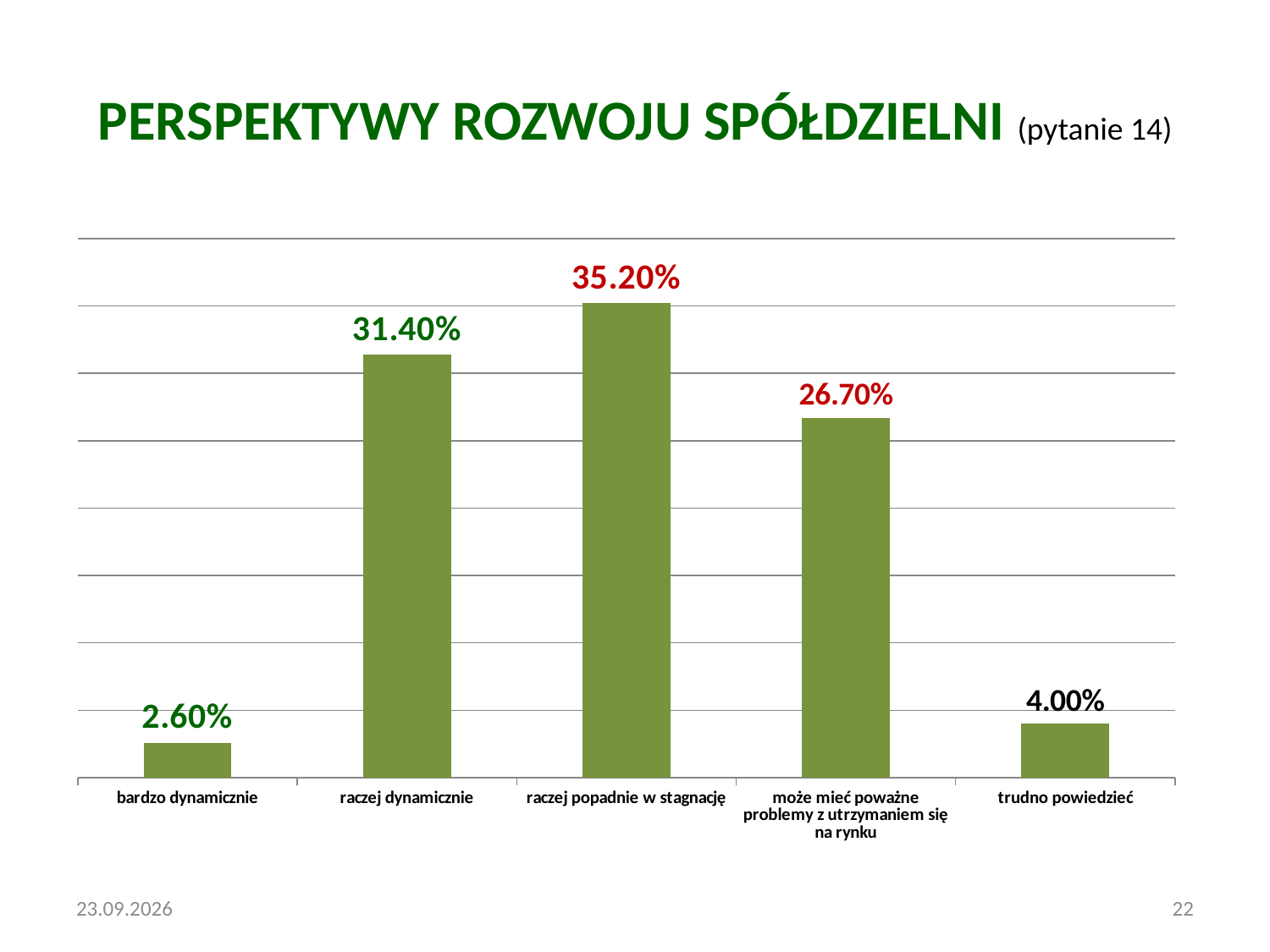
What is the value for "raczej popadnie w stagnację"? 35.20% What kind of chart is shown on the slide? bar chart How many categories are shown on the chart? 5 Which is larger, the value for "raczej dynamicznie" or the value for "może mieć poważne problemy z utrzymaniem się na rynku"? raczej dynamicznie What is the value for "bardzo dynamicznie"? 2.60% What is the value for "może mieć poważne problemy z utrzymaniem się na rynku"? 26.70% Which category has the lowest value? bardzo dynamicznie What is the title of the slide? PERSPEKTYWY ROZWOJU SPÓŁDZIELNI (pytanie 14) What is the difference between the values for "raczej popadnie w stagnację" and "raczej dynamicznie"? 3.80% What is the difference between the values for "trudno powiedzieć" and "bardzo dynamicznie"? 1.40% Which category has the highest value? raczej popadnie w stagnację What is the value for "trudno powiedzieć"? 4.00%